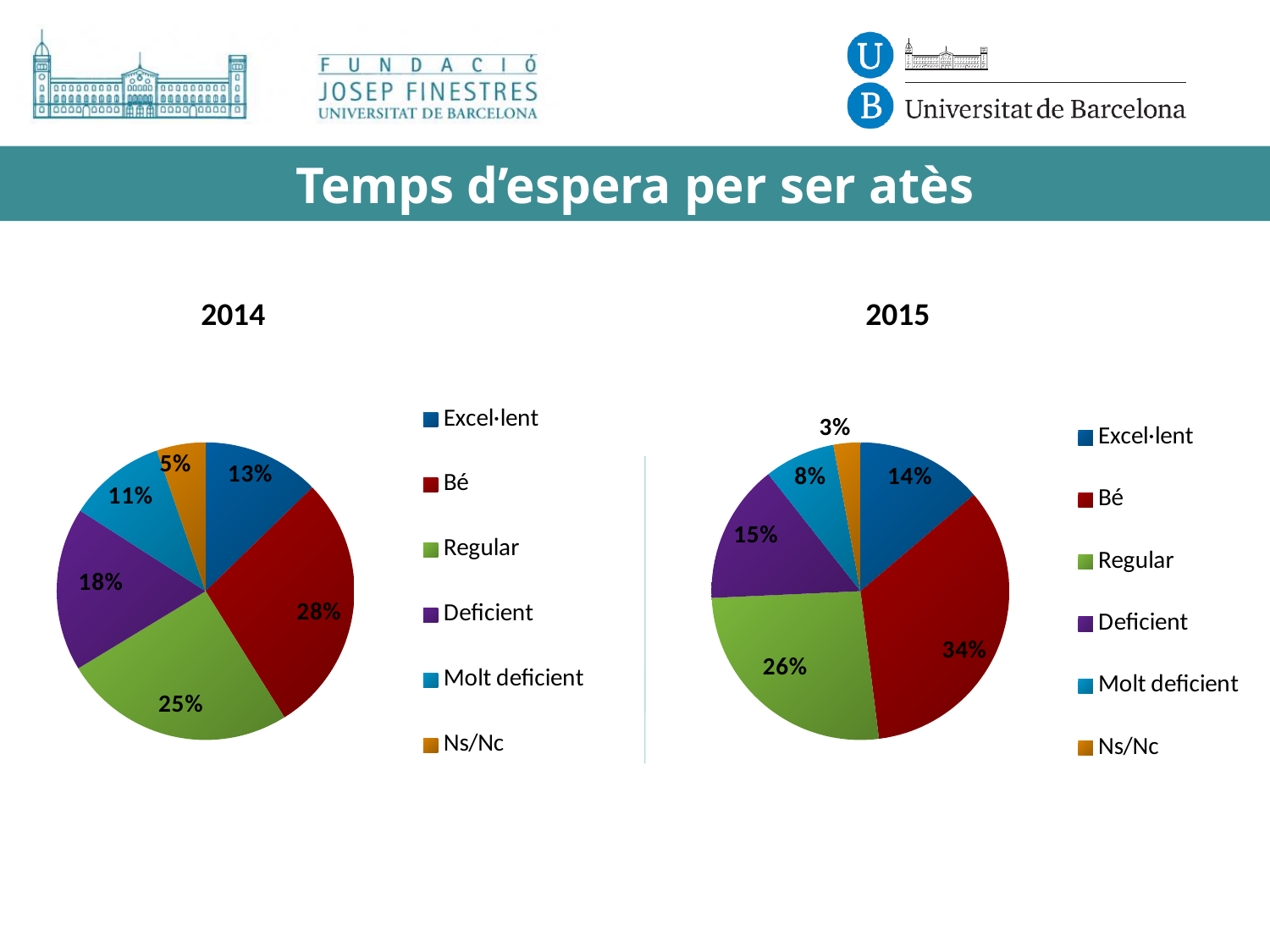
What kind of chart is used for the 2014 data? Pie chart In the 2015 pie chart, what is the share for Ns/Nc? 3% How many categories does the legend of the 2015 pie chart list? 6 What is the difference between the Bé share in 2015 and the Bé share in 2014? 6% In the 2014 pie chart, which is larger: Deficient or Molt deficient? Deficient In the 2015 pie chart, which category has the smallest slice? Ns/Nc In the 2014 pie chart, which category has the smallest slice? Ns/Nc In the 2014 pie chart, what is the share for Molt deficient? 11% What is the title of the slide containing the two pie charts? Temps d'espera per ser atès In the 2014 pie chart, what is the share for Bé? 28% In the 2015 pie chart, what is the share for Regular? 26% In the 2015 pie chart, which category has the largest slice? Bé